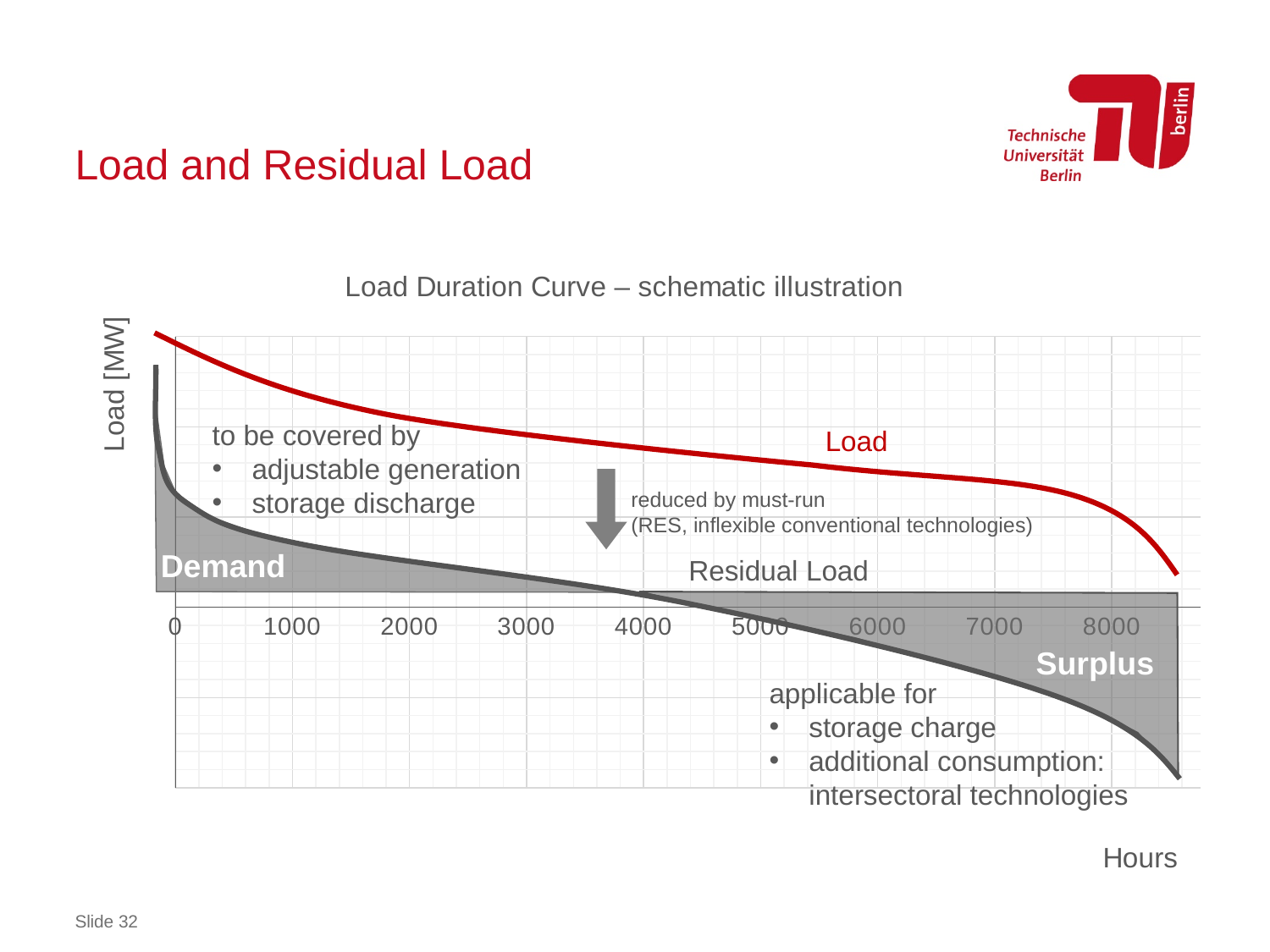
Does the Load curve rise or fall as hours increase along the x axis? fall How many curves are plotted on the chart? 2 What is the title of the chart? Load Duration Curve – schematic illustration Which curve is higher at 7000 hours, Load or Residual Load? Load Which curve is higher at 2000 hours, Load or Residual Load? Load What are the names of the two curves plotted on the chart? Load and Residual Load Does the Residual Load curve rise or fall as hours increase along the x axis? fall What kind of chart is shown on the slide? line chart What is the label of the y axis? Load [MW] Is the number of hours at which the Residual Load curve crosses zero greater or less than 3000? greater